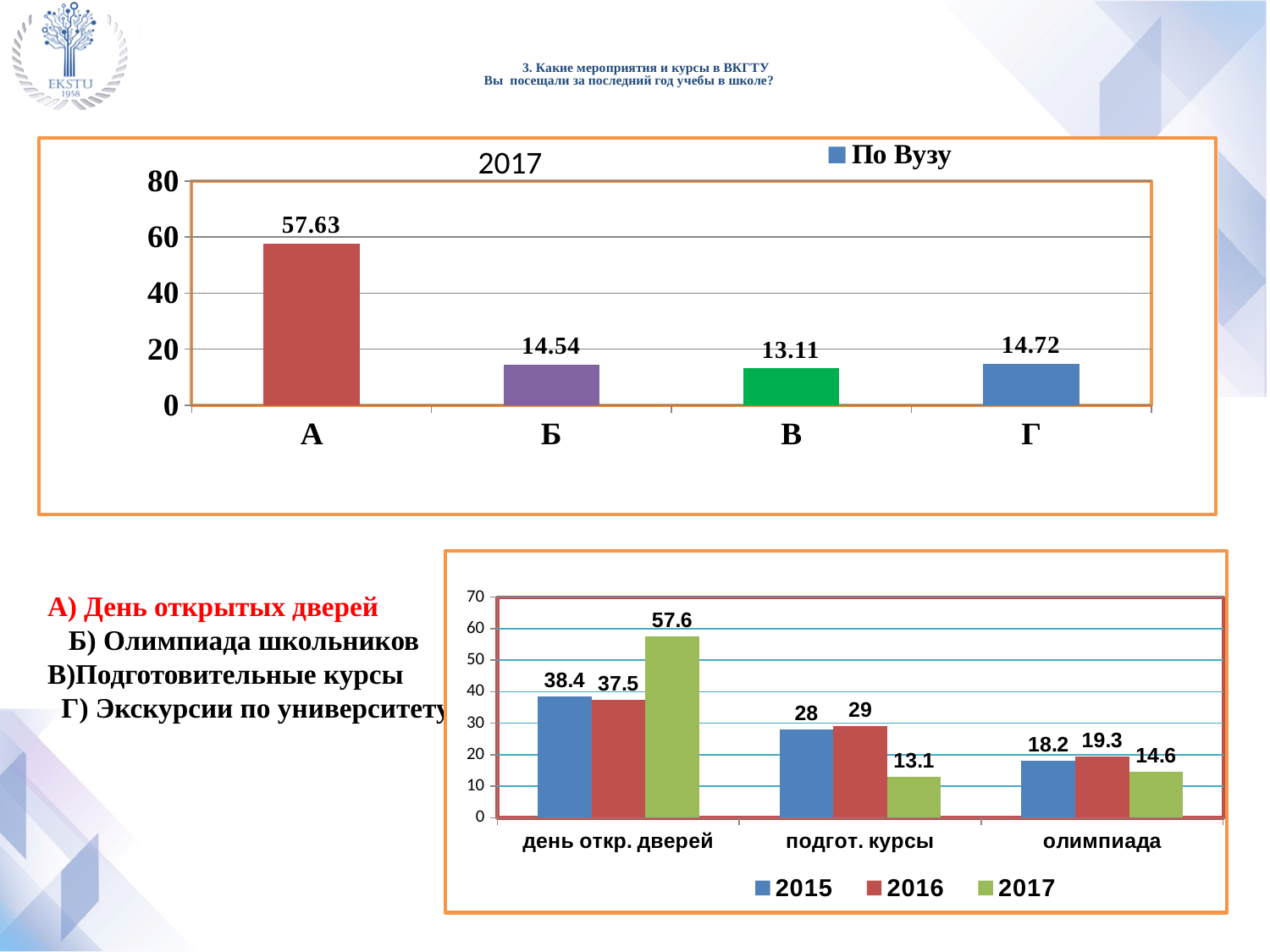
In the bottom chart, how many series does the legend list? 3 In the bottom chart, which is larger for "олимпиада": the 2016 value or the 2017 value? 2016 In the top chart titled "2017", how many categories are shown on the x axis? 4 In the top chart titled "2017", what is the value for category А? 57.63 In the bottom chart, what is the difference between the 2015 and 2017 values for "подгот. курсы"? 14.9 What kind of chart is the bottom chart? bar chart In the bottom chart, what is the 2016 value for "подгот. курсы"? 29 In the top chart titled "2017", which category has the lowest value? В In the top chart titled "2017", what is the legend entry? По Вузу In the top chart titled "2017", what is the difference between the values for А and Б? 43.09 In the bottom chart, which category has the highest 2015 value? день откр. дверей In the bottom chart, what is the 2017 value for "день откр. дверей"? 57.6